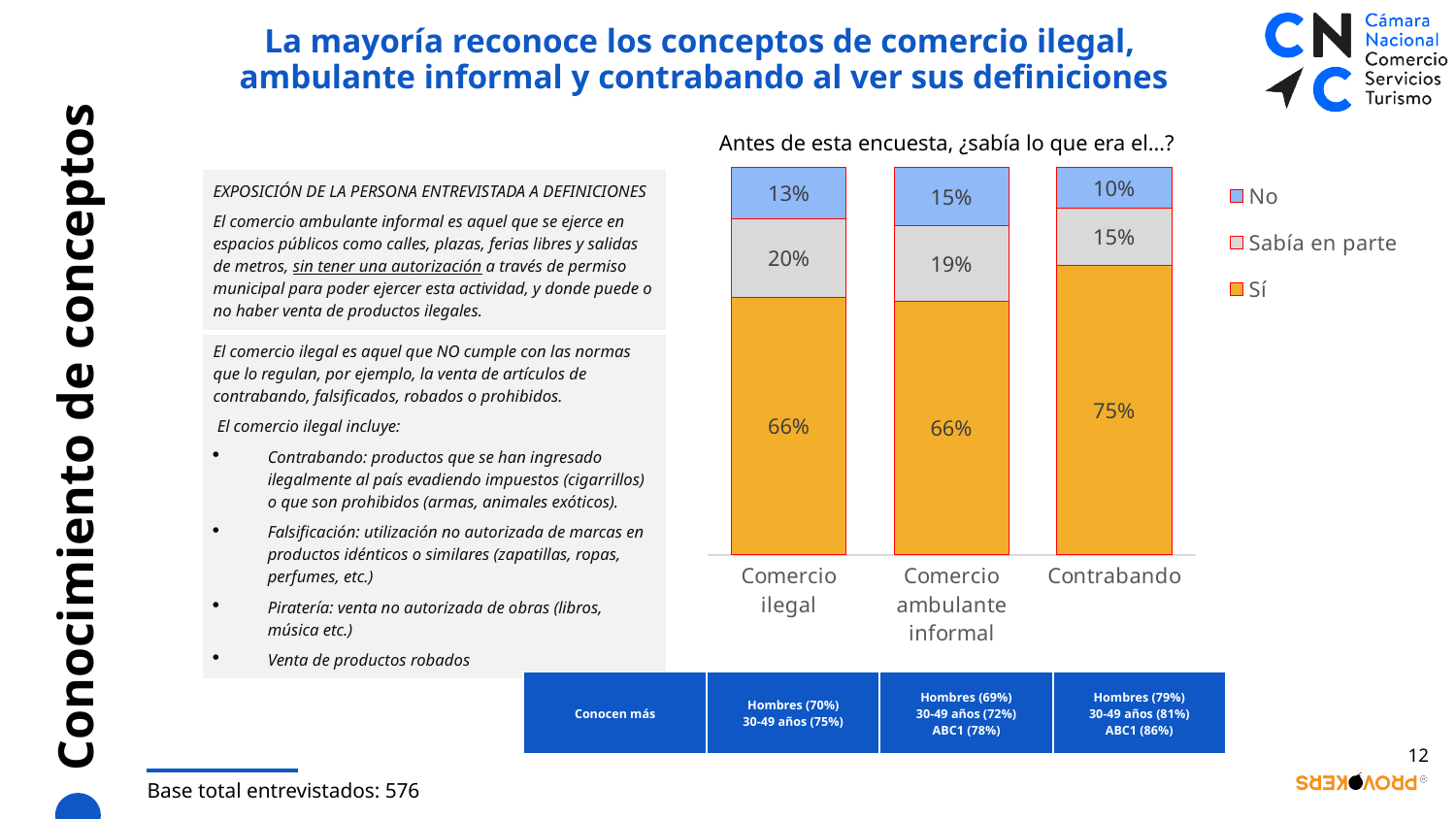
Which category has the highest "Sí" percentage? Contrabando What is the total of the stacked bar for Contrabando? 100% Which is larger: the "No" value for Comercio ambulante informal or the "No" value for Contrabando? Comercio ambulante informal Which category has the lowest "No" percentage? Contrabando How many categories are shown on the x axis of the chart? 3 What is the "Sabía en parte" value for Comercio ambulante informal? 19% What percentage of respondents answered "Sí" for Contrabando? 75% What percentage of respondents answered "No" for Comercio ilegal? 13% What kind of chart is shown on the slide? Stacked bar chart What is the question shown as the title above the chart? Antes de esta encuesta, ¿sabía lo que era el…? How many series does the chart legend list? 3 What is the difference between the "Sí" value for Contrabando and the "Sí" value for Comercio ilegal? 9%